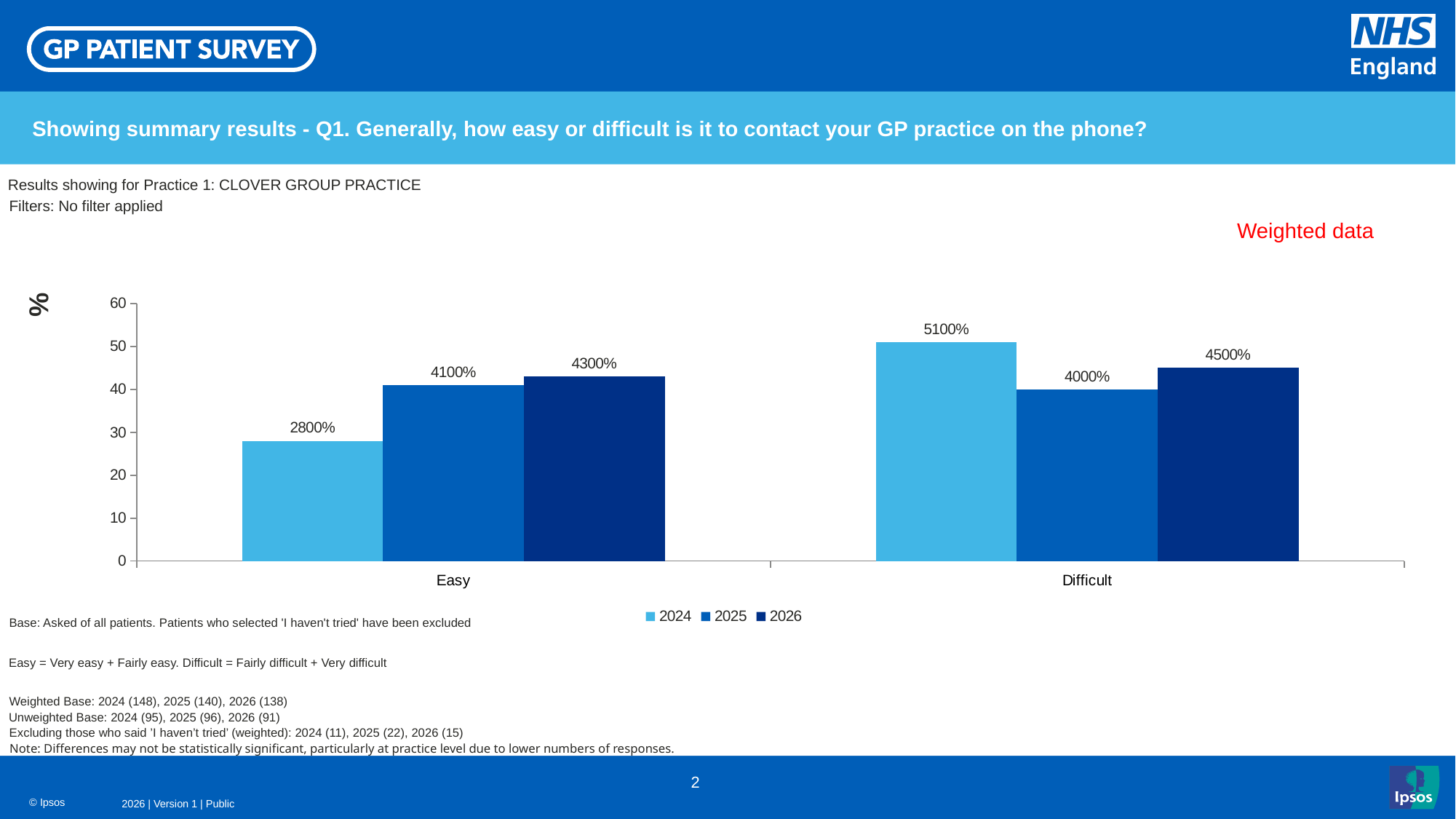
Which year has the lowest value in the Easy category? 2024 What is the value for 2025 in the Easy category? 4100% Is the 2025 bar for Difficult greater or less than 50 on the axis? less What is the value for 2024 in the Difficult category? 5100% What is the value for 2026 in the Difficult category? 4500% How many categories are shown on the x axis? 2 How many series does the legend list? 3 What are the legend entries for the chart? 2024, 2025, 2026 Which is larger in the Easy category: the 2025 value or the 2026 value? 2026 What kind of chart is shown on the slide? bar chart What is the value for 2024 in the Easy category? 2800% Which year has the highest value in the Difficult category? 2024